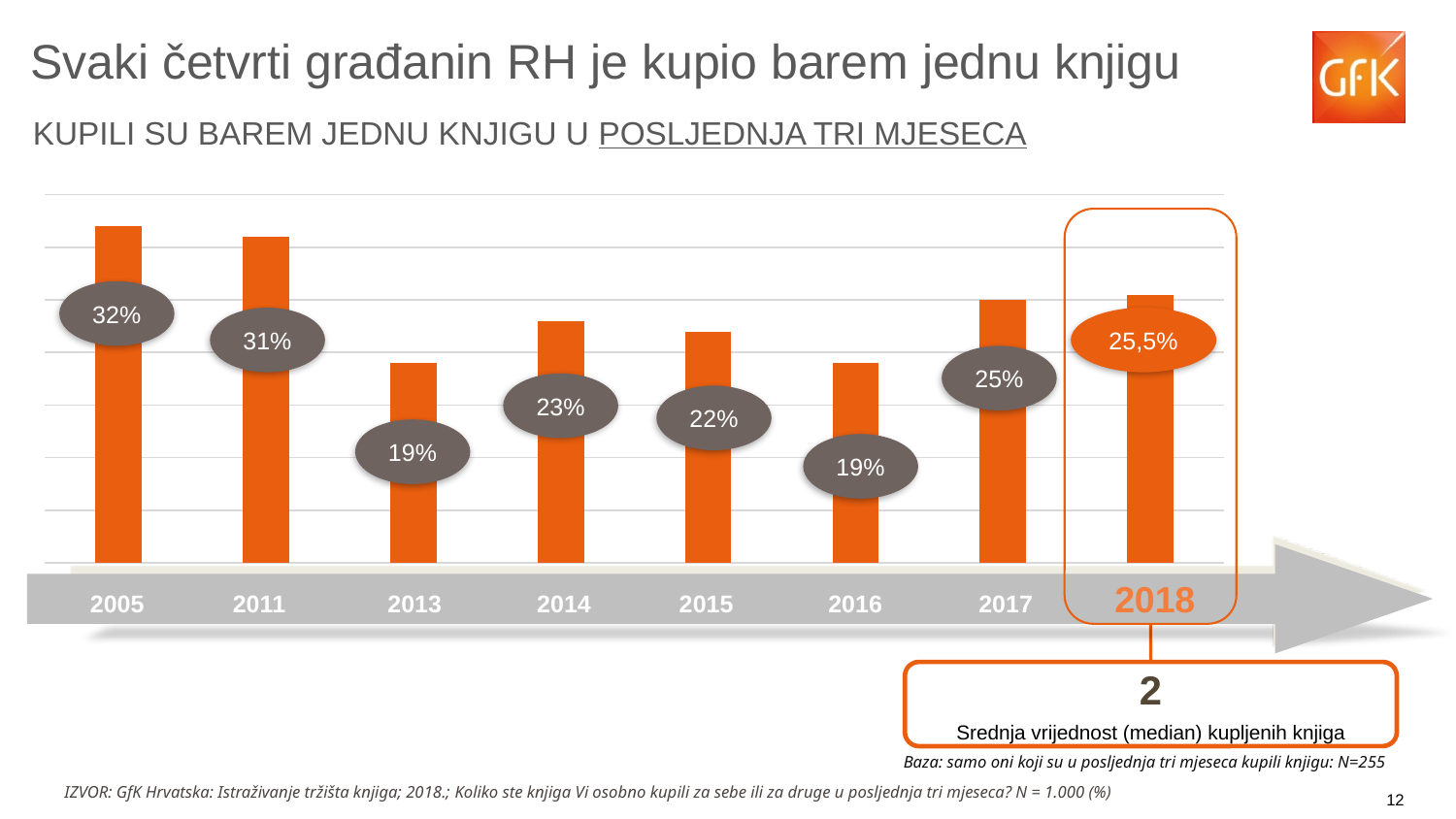
How many years are shown on the chart? 8 What percentage of respondents bought at least one book in the last three months in 2005? 32% Which year has the larger value, 2014 or 2015? 2014 What is the lowest value shown on the chart? 19% What is the median number of books purchased, as shown in the box below the chart? 2 Which year has the highest value on the chart? 2005 Did the value rise or fall from 2016 to 2017? Rise What is the difference between the values for 2005 and 2013? 13 percentage points What is the value shown for 2014? 23% What kind of chart is shown on the slide? Bar chart What is the value shown for 2018? 25,5% What is the difference between the values for 2018 and 2017? 0,5 percentage points